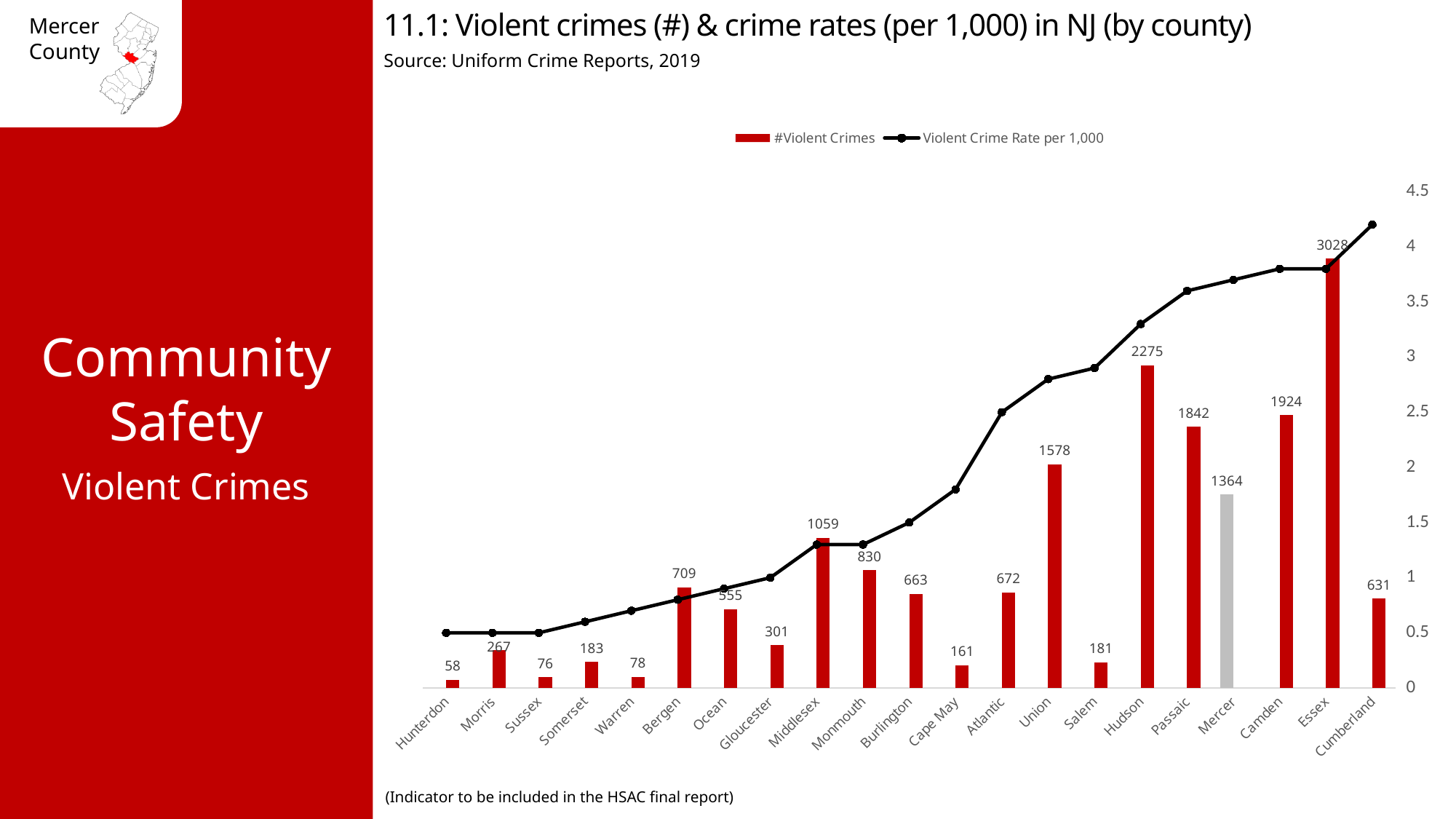
Which county has more violent crimes, Camden or Passaic? Camden How many counties are shown on the x axis? 21 How many series does the legend list? 2 Is the violent crime rate per 1,000 for Cumberland greater or less than 4? greater What is the number of violent crimes for Mercer? 1364 What is the difference in the number of violent crimes between Hudson and Passaic? 433 What kind of chart is this? Combined bar and line chart Which county has the highest number of violent crimes? Essex Is the violent crime rate per 1,000 for Hunterdon greater or less than 1? less What is the number of violent crimes for Essex? 3028 Does the Violent Crime Rate per 1,000 line generally rise or fall from Hunterdon to Cumberland? Rise Which county has the lowest number of violent crimes? Hunterdon